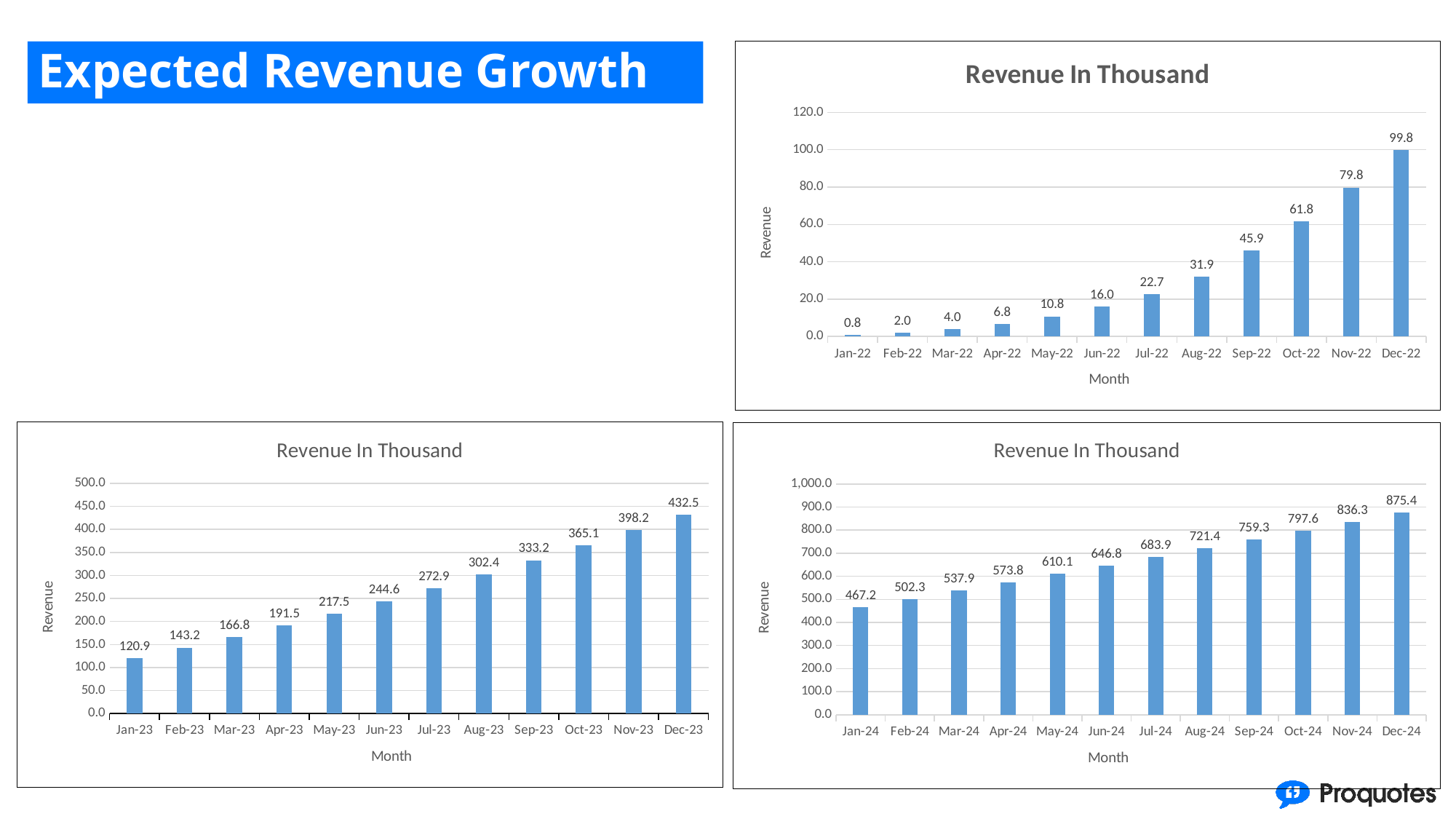
In the bottom-left chart (Jan-23 to Dec-23), what is the revenue value for Jun-23? 244.6 In the top-right chart (Jan-22 to Dec-22), what is the revenue value for Sep-22? 45.9 In the bottom-left chart (Jan-23 to Dec-23), how many months are plotted? 12 What is the title of the top-right chart? Revenue In Thousand In the top-right chart (Jan-22 to Dec-22), which month has the lowest revenue? Jan-22 In the top-right chart (Jan-22 to Dec-22), what is the difference between the Dec-22 and Nov-22 values? 20.0 In the bottom-right chart (Jan-24 to Dec-24), which is larger, the value for Mar-24 or the value for May-24? May-24 In the top-right chart (Jan-22 to Dec-22), which month has the highest revenue? Dec-22 In the bottom-right chart (Jan-24 to Dec-24), what is the revenue value for Aug-24? 721.4 What kind of chart is the bottom-right chart (Jan-24 to Dec-24)? bar chart In the bottom-left chart (Jan-23 to Dec-23), what is the difference between the Dec-23 and Jan-23 values? 311.6 In the bottom-right chart (Jan-24 to Dec-24), do the values rise or fall from Jan-24 to Dec-24? rise